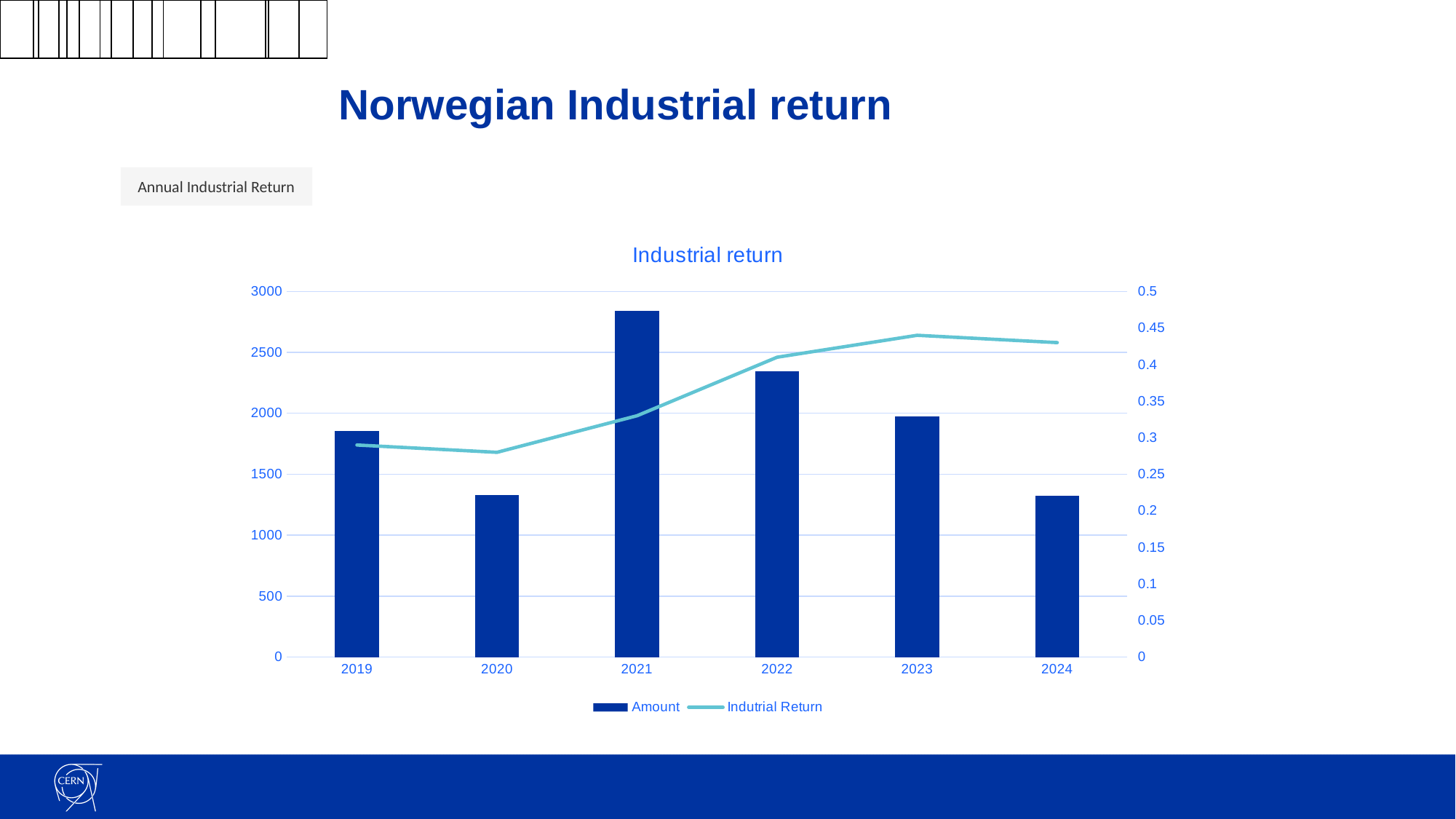
Which year has the larger Amount, 2019 or 2020? 2019 Is the Amount for 2022 greater or less than 2000? greater How many years are shown on the x axis of the chart? 6 How many series does the chart legend list? 2 Which year has the highest Amount bar? 2021 Does the Indutrial Return line rise or fall from 2020 to 2023? rise What is the title of the chart? Industrial return Is the Amount for 2020 greater or less than 1500? less Is the Amount for 2021 greater or less than 2500? greater What kind of chart is shown on the slide? A combined bar and line chart